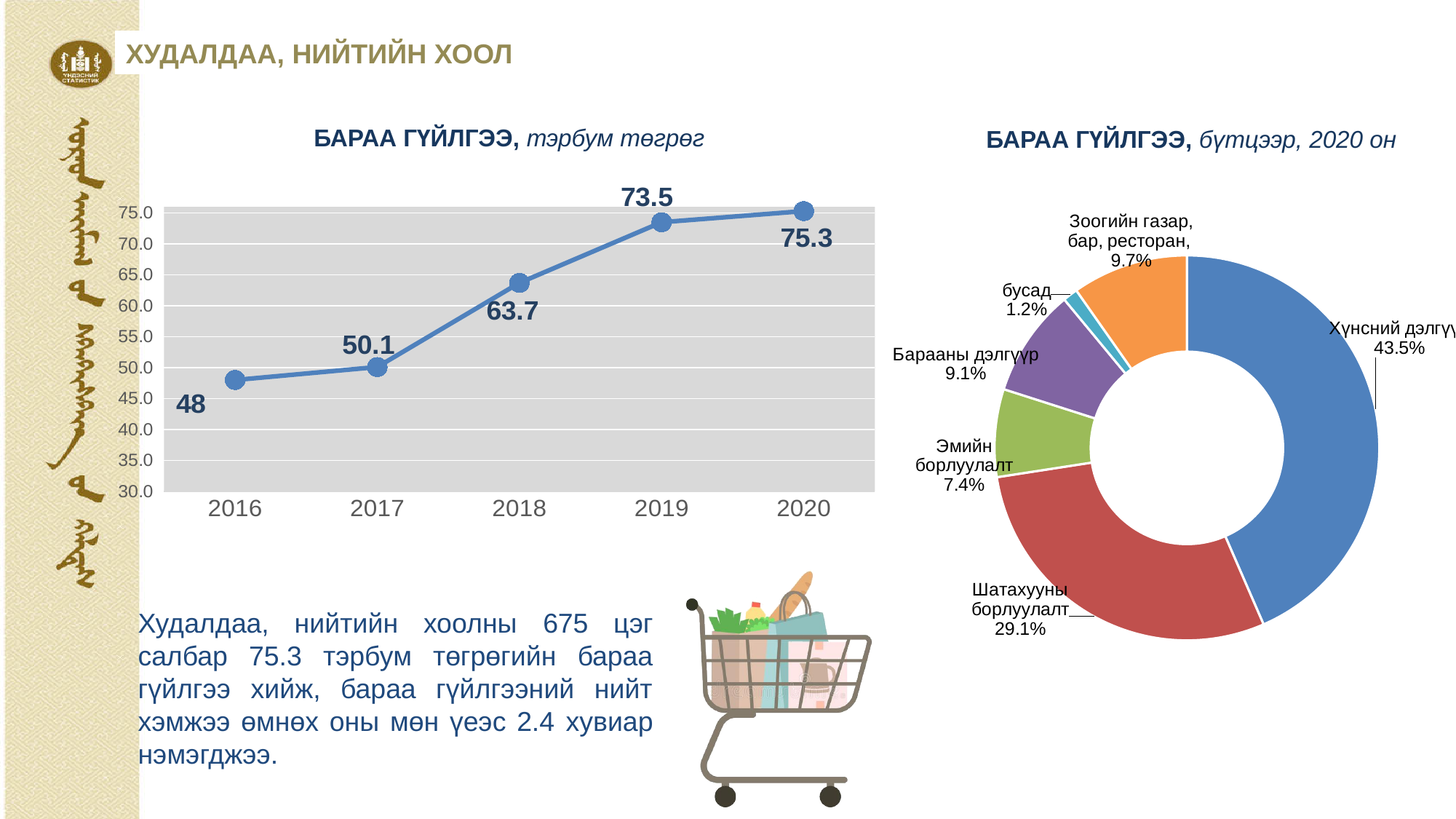
In the line chart 'БАРАА ГҮЙЛГЭЭ, тэрбум төгрөг', what is the value for 2016? 48 In the doughnut chart 'БАРАА ГҮЙЛГЭЭ, бүтцээр, 2020 он', which category has the largest share? Хүнсний дэлгүүр What kind of chart is 'БАРАА ГҮЙЛГЭЭ, тэрбум төгрөг' on the left of the slide? line chart In the line chart 'БАРАА ГҮЙЛГЭЭ, тэрбум төгрөг', which year has the highest value? 2020 In the line chart 'БАРАА ГҮЙЛГЭЭ, тэрбум төгрөг', how many years are plotted? 5 In the line chart 'БАРАА ГҮЙЛГЭЭ, тэрбум төгрөг', what is the difference between the 2020 and 2019 values? 1.8 In the doughnut chart 'БАРАА ГҮЙЛГЭЭ, бүтцээр, 2020 он', which is larger: Барааны дэлгүүр or Эмийн борлуулалт? Барааны дэлгүүр In the line chart 'БАРАА ГҮЙЛГЭЭ, тэрбум төгрөг', what is the value for 2018? 63.7 In the doughnut chart 'БАРАА ГҮЙЛГЭЭ, бүтцээр, 2020 он', what share does Шатахууны борлуулалт have? 29.1% In the line chart 'БАРАА ГҮЙЛГЭЭ, тэрбум төгрөг', which year has the lowest value? 2016 In the doughnut chart 'БАРАА ГҮЙЛГЭЭ, бүтцээр, 2020 он', which category has the smallest share? бусад In the line chart 'БАРАА ГҮЙЛГЭЭ, тэрбум төгрөг', do the values rise or fall from 2016 to 2020? rise